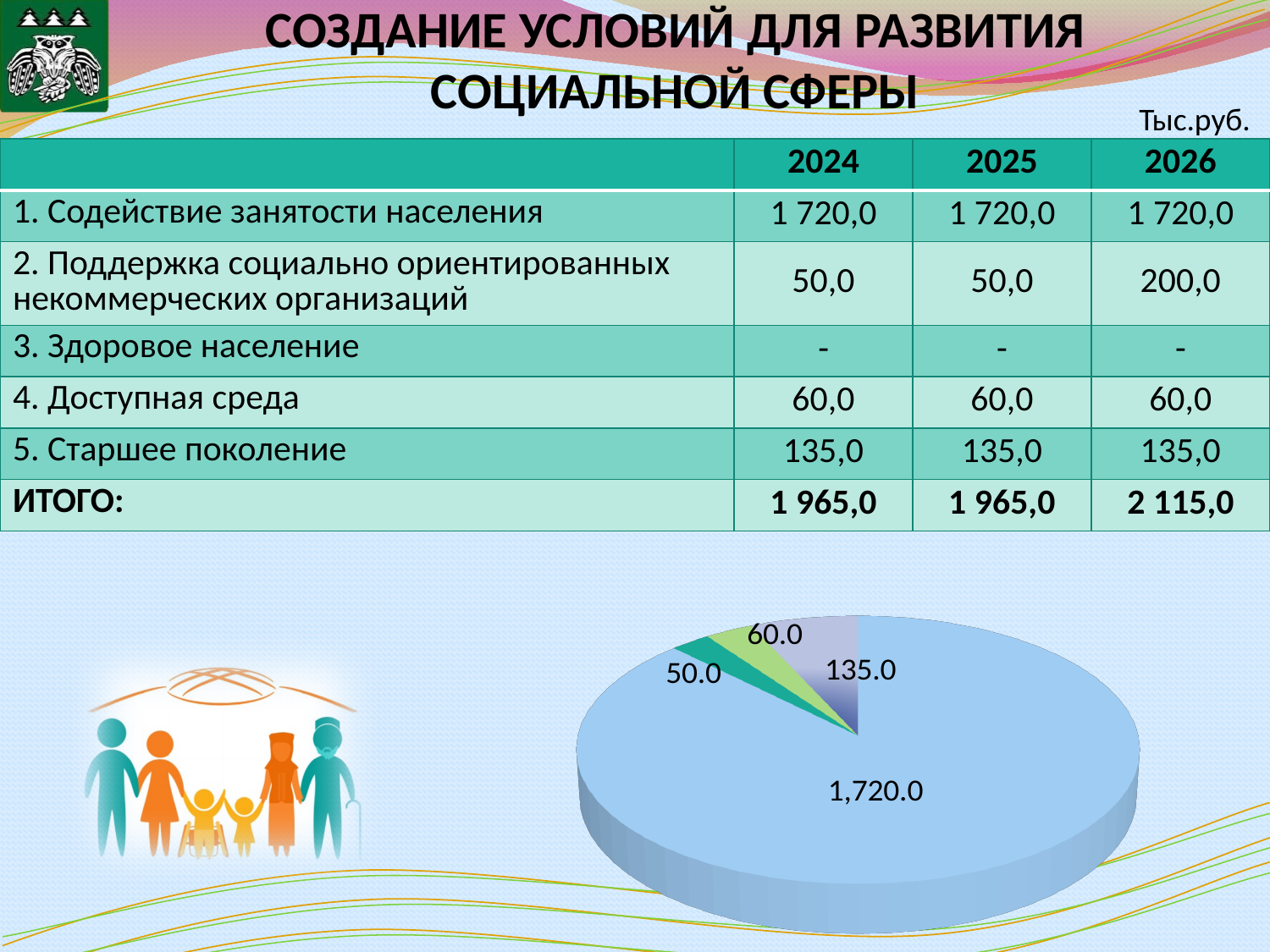
In the pie chart, what is the difference between the largest slice and the 135.0 slice? 1,585.0 What is the value shown on the grey-purple slice of the pie chart? 135.0 What kind of chart is shown at the bottom of the slide? pie chart What is the value shown on the teal slice of the pie chart? 50.0 What is the value of the smallest slice in the pie chart? 50.0 How many slices does the pie chart have? 4 In the pie chart, which slice is larger: the one labelled 60.0 or the one labelled 50.0? 60.0 What colour is the largest slice of the pie chart? light blue What is the value shown on the green slice of the pie chart? 60.0 What is the value of the largest slice in the pie chart? 1,720.0 What is the total of all slice values in the pie chart? 1,965.0 In the pie chart, what is the difference between the 135.0 slice and the 60.0 slice? 75.0